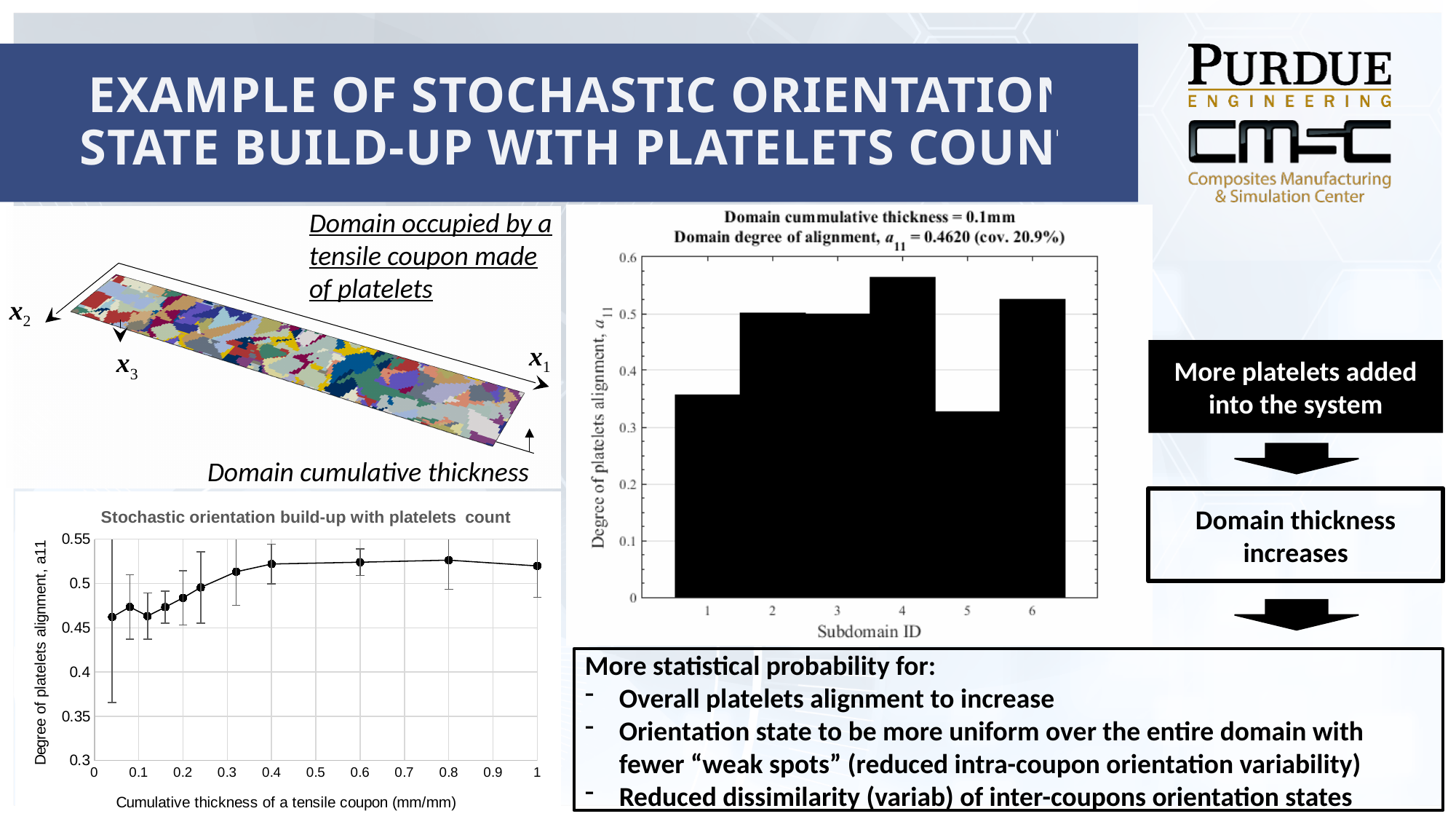
What is the x-axis label of the bottom-left chart 'Stochastic orientation build-up with platelets count'? Cumulative thickness of a tensile coupon (mm/mm) What kind of chart is the chart on the right titled 'Domain cummulative thickness = 0.1mm'? bar chart In the bar chart on the right, how many subdomain IDs are shown on the x axis? 6 In the bar chart on the right, which has a larger degree of platelets alignment, subdomain 4 or subdomain 5? subdomain 4 In the bottom-left chart 'Stochastic orientation build-up with platelets count', does the degree of platelets alignment generally rise or fall as cumulative thickness increases? rise What kind of chart is the bottom-left chart titled 'Stochastic orientation build-up with platelets count'? line chart According to the title of the bar chart on the right, what is the domain degree of alignment a11? 0.4620 (cov. 20.9%) In the bottom-left chart 'Stochastic orientation build-up with platelets count', is the value at cumulative thickness 1 greater or less than 0.5? greater In the bar chart on the right, which subdomain ID has the lowest degree of platelets alignment? 5 In the bar chart on the right, which subdomain ID has the highest degree of platelets alignment? 4 In the bar chart on the right, is the value for subdomain 1 greater or less than 0.4? less In the bar chart on the right, is the value for subdomain 4 greater or less than 0.5? greater